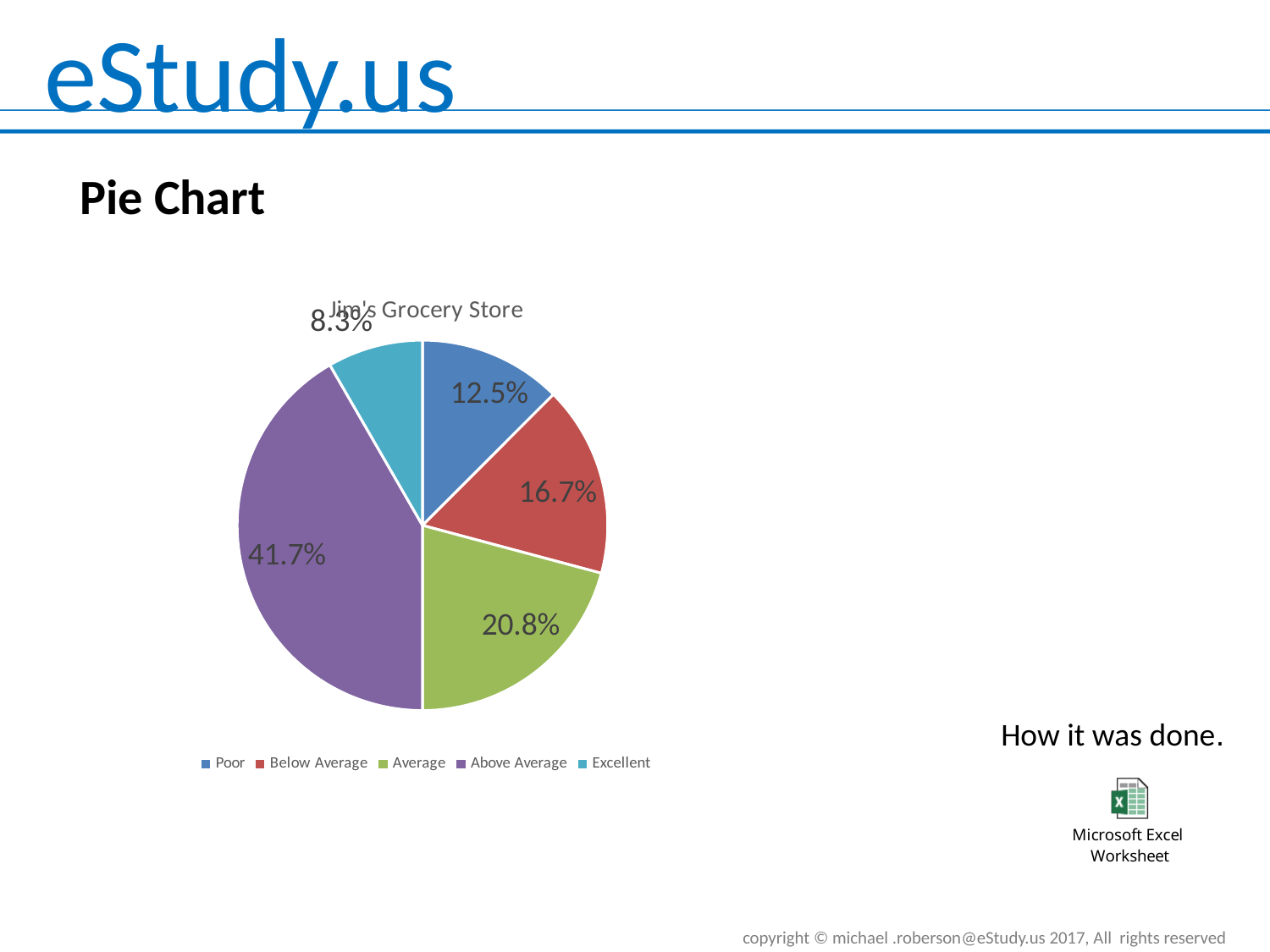
What kind of chart is shown on the slide? pie chart Which category has the largest slice of the pie? Above Average What percentage of the pie is labelled for the Poor slice? 12.5% What percentage is shown for the Excellent slice? 8.3% What percentage is shown for the Above Average slice? 41.7% Which category has the smallest slice of the pie? Excellent What percentage is shown for the Average slice? 20.8% What is the difference in percentage points between the Above Average slice and the Poor slice? 29.2 What is the title of the pie chart? Jim's Grocery Store How many categories does the legend list? 5 What percentage is shown for the Below Average slice? 16.7% Which slice is larger, Average or Below Average? Average